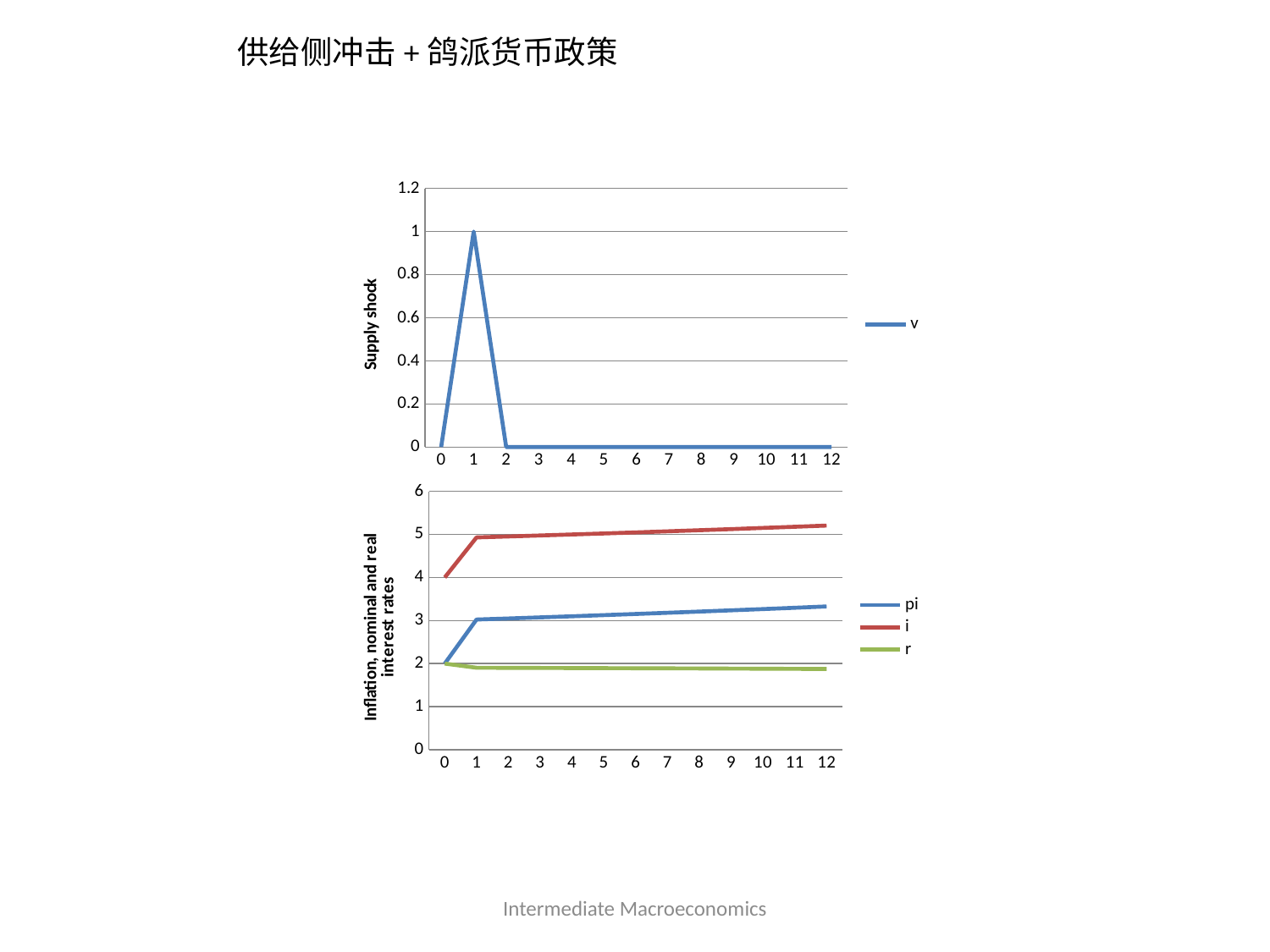
In the bottom chart, what is the value of pi at period 0? 2 What kind of chart is the top chart (Supply shock)? line chart How many periods are shown on the x axis of the top chart? 13 In the top chart, what is the value of v at period 1? 1 How many series does the legend of the bottom chart list? 3 In the top chart, what is the value of v at period 5? 0 In the bottom chart, is the value of r at period 12 greater or less than 2? less In the top chart, at which period is v highest? 1 In the bottom chart, does the i series rise or fall from period 1 to period 12? rise In the bottom chart, what is the value of i at period 0? 4 In the bottom chart, which series has the highest values across periods 1 to 12? i In the bottom chart, is the value of i at period 12 greater or less than 5? greater